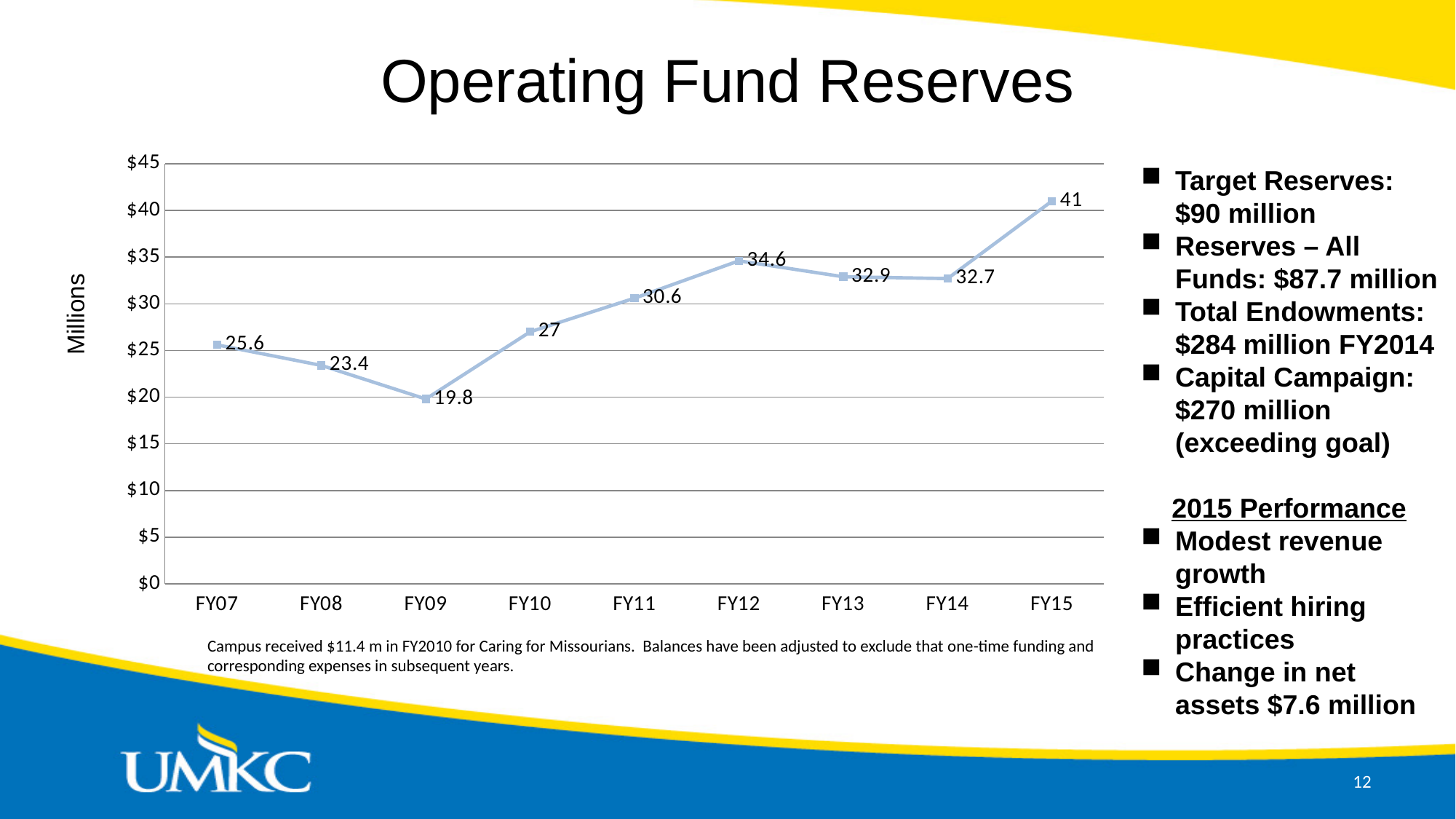
Which is larger, the value for FY08 or the value for FY10? FY10 How many fiscal years are plotted on the chart? 9 Which fiscal year has the lowest value? FY09 What is the value for FY09? 19.8 What is the value for FY12? 34.6 What is the difference between the FY15 value and the FY14 value? 8.3 What is the difference between the FY07 value and the FY09 value? 5.8 What is the value for FY15? 41 What kind of chart is shown on the slide? Line chart Is the value for FY11 greater or less than $30? greater What is the label on the vertical axis of the chart? Millions Which fiscal year has the highest value? FY15